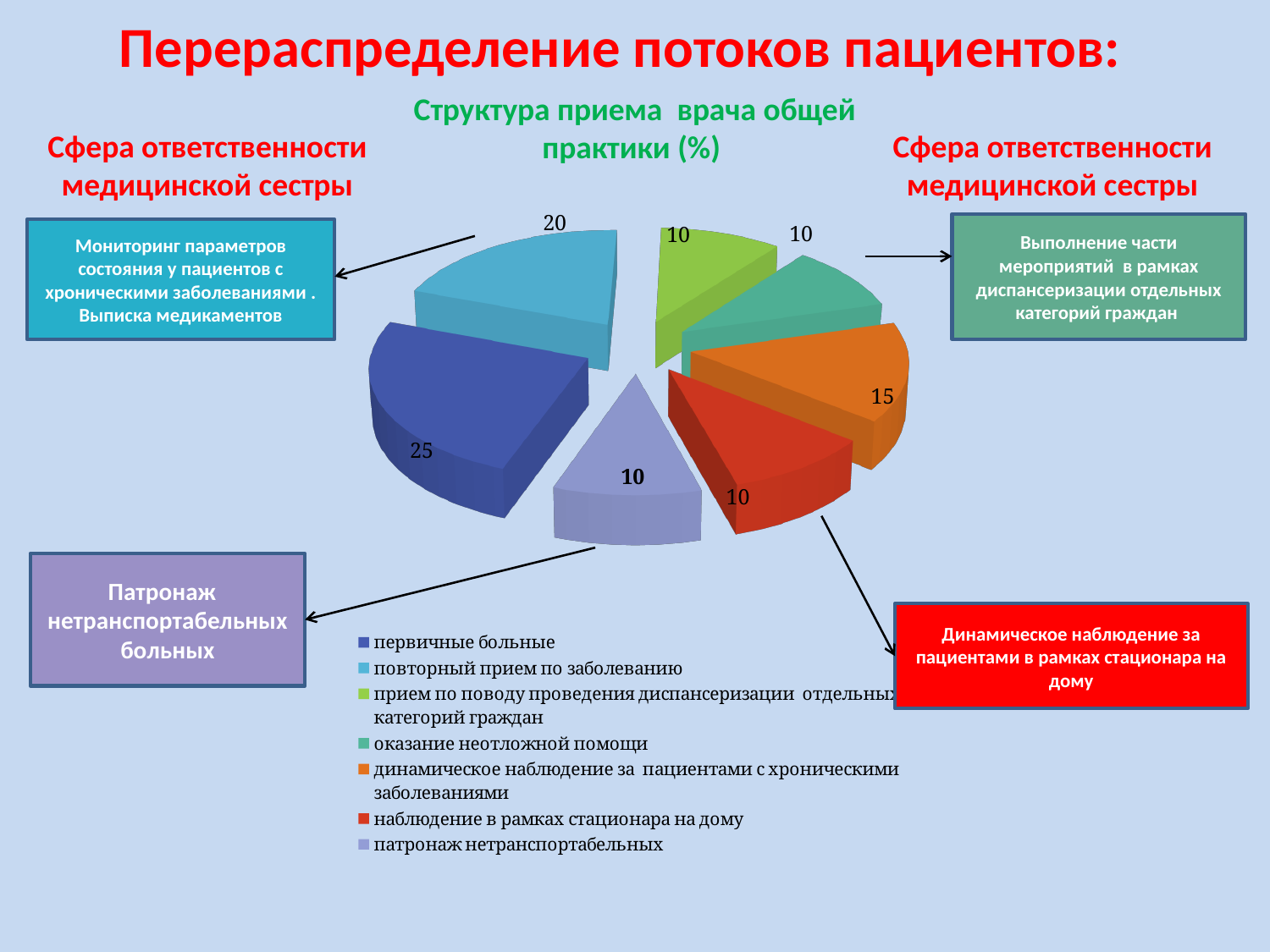
What is the difference between the values for "первичные больные" and "повторный прием по заболеванию"? 5 What is the value for "патронаж нетранспортабельных"? 10 What kind of chart is shown on the slide? pie chart What colour is the slice for "наблюдение в рамках стационара на дому"? red Which category has the largest slice of the pie? первичные больные What is the value for "первичные больные"? 25 What is the chart's title? Структура приема врача общей практики (%) How many slices does the pie chart have? 7 What is the value for "повторный прием по заболеванию"? 20 Which is larger: "динамическое наблюдение за пациентами с хроническими заболеваниями" or "наблюдение в рамках стационара на дому"? динамическое наблюдение за пациентами с хроническими заболеваниями How many entries does the legend list? 7 What is the value for "динамическое наблюдение за пациентами с хроническими заболеваниями"? 15